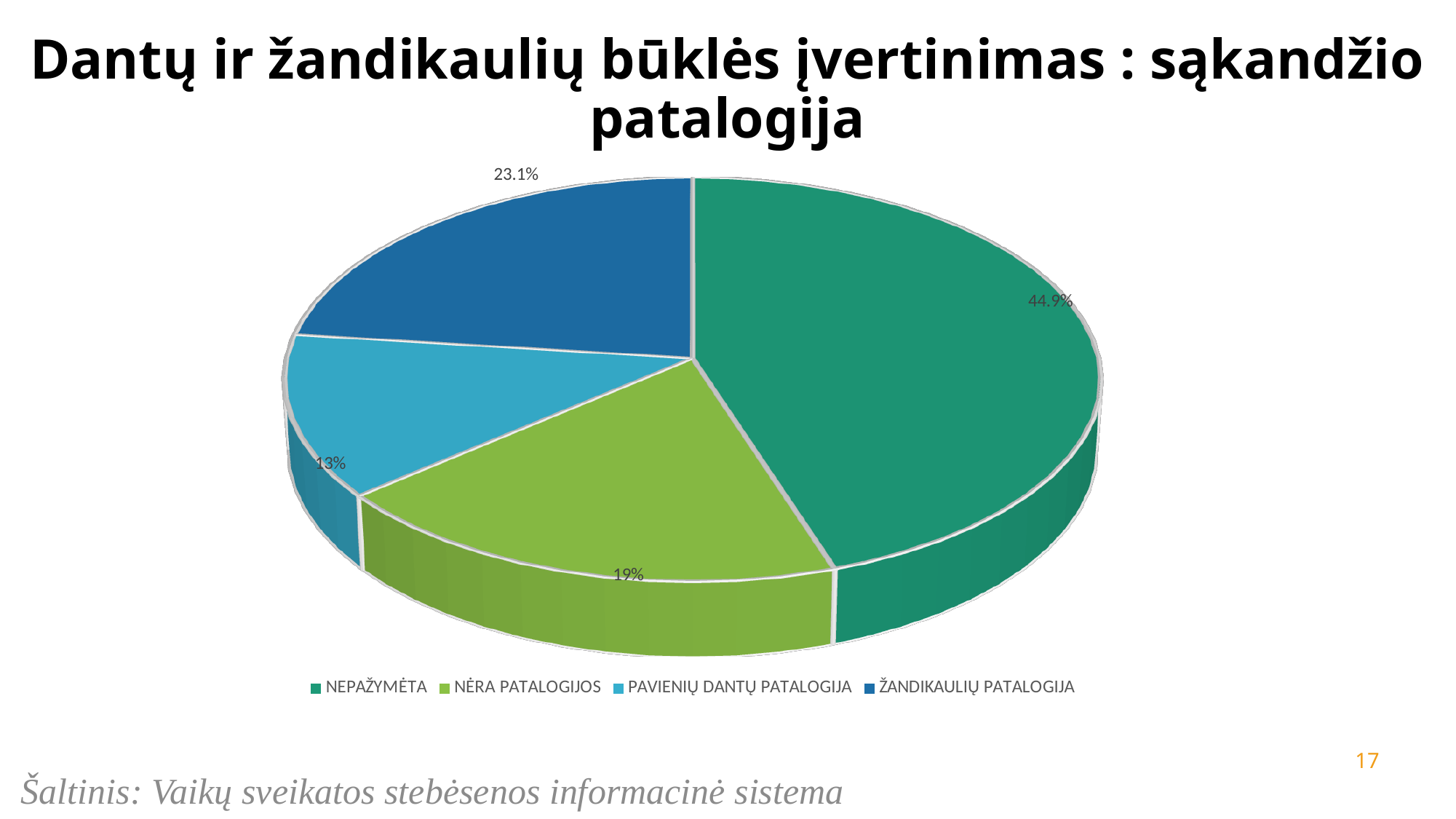
What kind of chart is shown on the slide? pie chart What share of the pie does PAVIENIŲ DANTŲ PATALOGIJA have? 13% How many categories does the pie chart have? 4 Which category has the smallest slice of the pie? PAVIENIŲ DANTŲ PATALOGIJA Which is larger, the slice for ŽANDIKAULIŲ PATALOGIJA or the slice for NĖRA PATALOGIJOS? ŽANDIKAULIŲ PATALOGIJA What share of the pie does ŽANDIKAULIŲ PATALOGIJA have? 23.1% What is the difference in percentage points between the NEPAŽYMĖTA slice and the ŽANDIKAULIŲ PATALOGIJA slice? 21.8 What share of the pie does NĖRA PATALOGIJOS have? 19% What is the difference in percentage points between the NĖRA PATALOGIJOS slice and the PAVIENIŲ DANTŲ PATALOGIJA slice? 6 What share of the pie does NEPAŽYMĖTA have? 44.9% Which category has the largest slice of the pie? NEPAŽYMĖTA What colour is the slice for ŽANDIKAULIŲ PATALOGIJA? dark blue